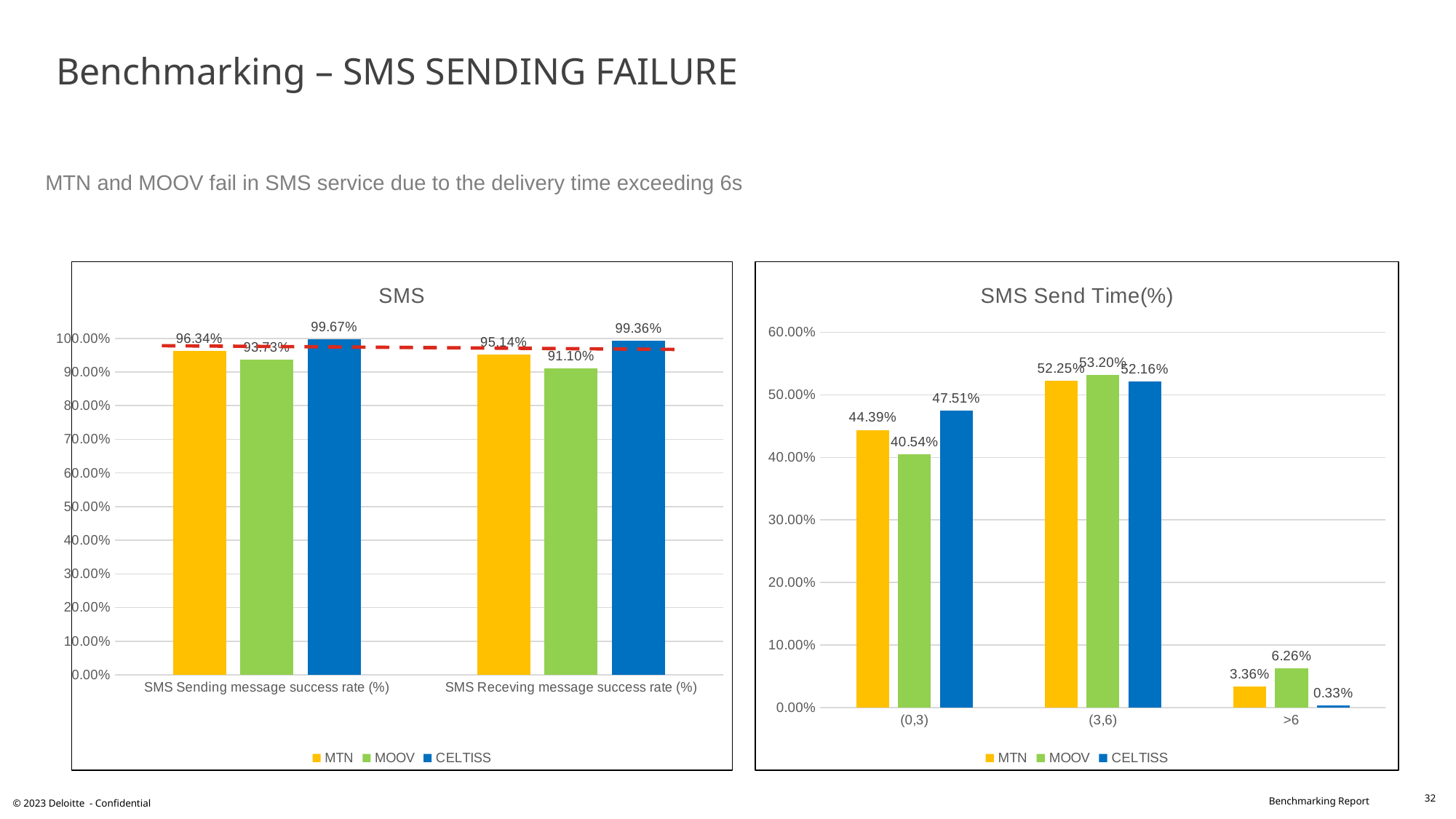
How many series does the legend of the "SMS Send Time(%)" chart list? 3 In the "SMS Send Time(%)" chart, how many categories are shown on the x axis? 3 In the "SMS" chart, which is larger: MTN's SMS Sending message success rate or MTN's SMS Receving message success rate? SMS Sending message success rate In the "SMS Send Time(%)" chart, what is the difference between MOOV and MTN in the >6 category? 2.90% In the "SMS Send Time(%)" chart, which operator has the highest value in the >6 category? MOOV In the "SMS" chart, what is the SMS Sending message success rate (%) for CELTISS? 99.67% In the "SMS" chart, what is the difference between the SMS Sending message success rate of CELTISS and MTN? 3.33% In the "SMS" chart, which operator has the lowest SMS Receving message success rate (%)? MOOV In the "SMS" chart, what is the SMS Receving message success rate (%) for MOOV? 91.10% In the "SMS Send Time(%)" chart, what is the value for CELTISS in the >6 category? 0.33% What type of chart is the "SMS" chart? Bar chart In the "SMS Send Time(%)" chart, what is the value for MOOV in the (0,3) category? 40.54%